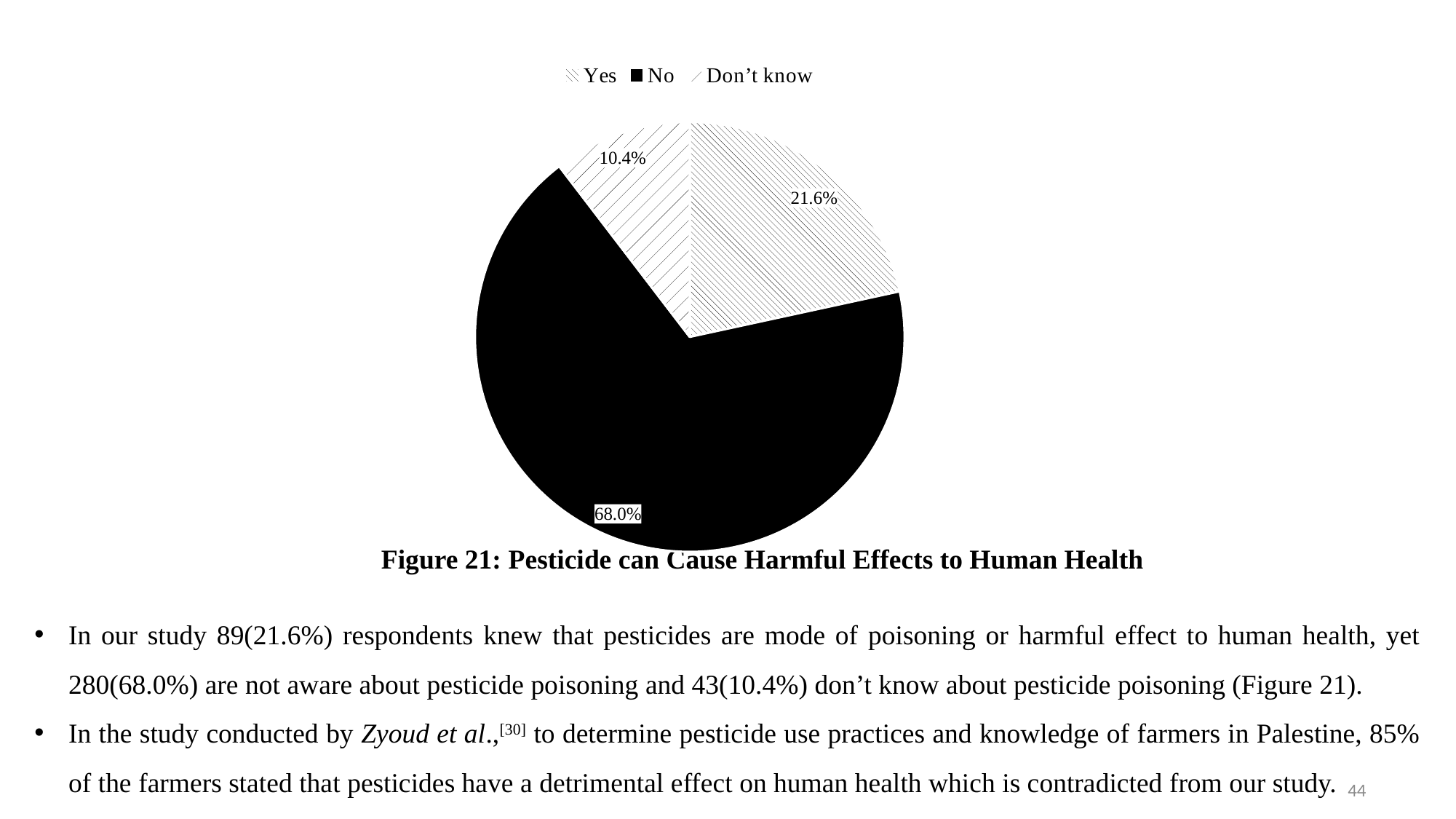
How many entries does the legend list? 3 What is the difference in percentage points between the "No" slice and the "Yes" slice? 46.4 What is the difference in percentage points between the "Yes" slice and the "Don't know" slice? 11.2 Which category has the largest slice of the pie? No What type of chart is shown in Figure 21? pie chart How many slices does the pie chart have? 3 Which category has the smallest slice of the pie? Don't know Which slice is larger, "Yes" or "Don't know"? Yes What is the title of the figure shown on the slide? Figure 21: Pesticide can Cause Harmful Effects to Human Health What percentage is shown for the "Yes" slice? 21.6% What percentage of the pie is labelled for the "No" slice? 68.0% What percentage is shown for the "Don't know" slice? 10.4%